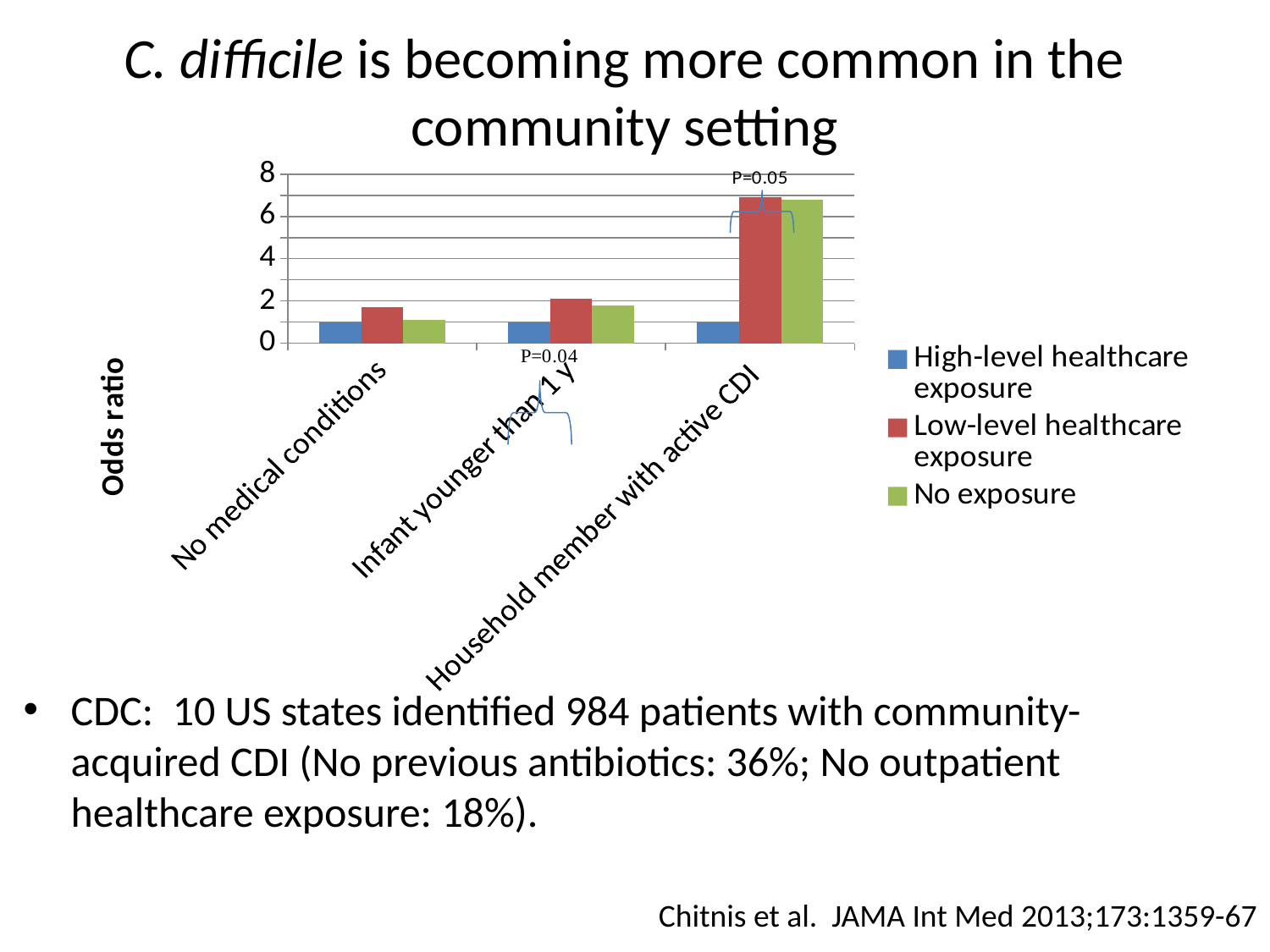
For Infant younger than 1 y, which is larger: the Low-level healthcare exposure bar or the High-level healthcare exposure bar? Low-level healthcare exposure Is the Low-level healthcare exposure value for Household member with active CDI greater or less than 6? greater How many categories are shown on the x axis of the chart? 3 Which series is shown in green in the chart's legend? No exposure Which category has the lowest No exposure bar? No medical conditions Is the High-level healthcare exposure value for No medical conditions greater or less than 2? less Is the No exposure value for Infant younger than 1 y greater or less than 4? less What is the title of the chart's vertical axis? Odds ratio Which category has the highest Low-level healthcare exposure bar? Household member with active CDI What kind of chart is shown on the slide? bar chart How many series does the chart's legend list? 3 For Household member with active CDI, which is larger: the No exposure bar or the High-level healthcare exposure bar? No exposure